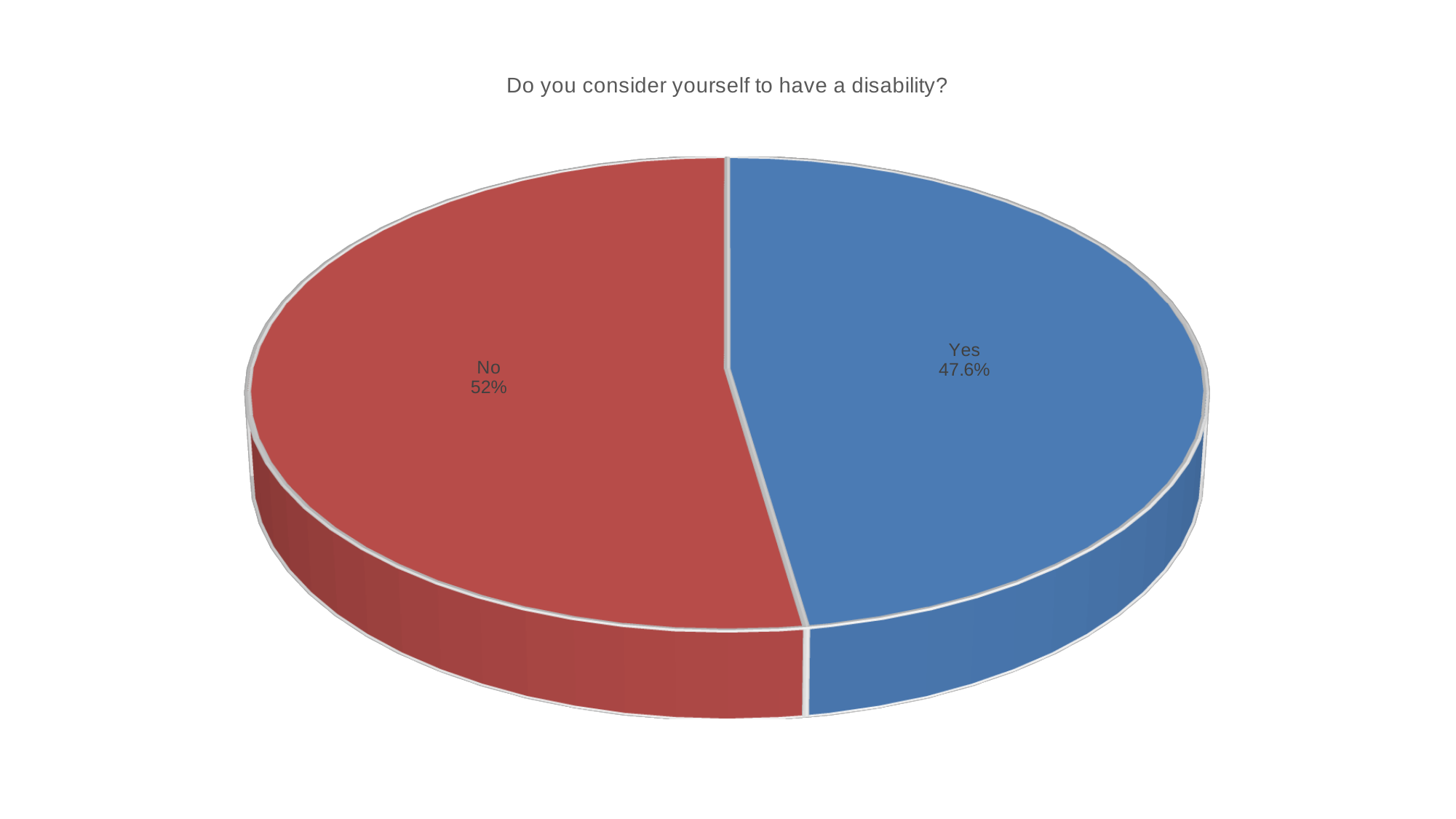
Which slice is larger, "Yes" or "No"? No What share of the pie is labelled "No"? 52% Which slice is the largest? No What is the difference in percentage points between the "No" and "Yes" slices? 4.4 Which slice is the smallest? Yes How many slices does the pie chart have? 2 What kind of chart is shown on the slide? Pie chart What share of the pie is labelled "Yes"? 47.6% What is the title of the chart? Do you consider yourself to have a disability? What colour is the "Yes" slice? Blue